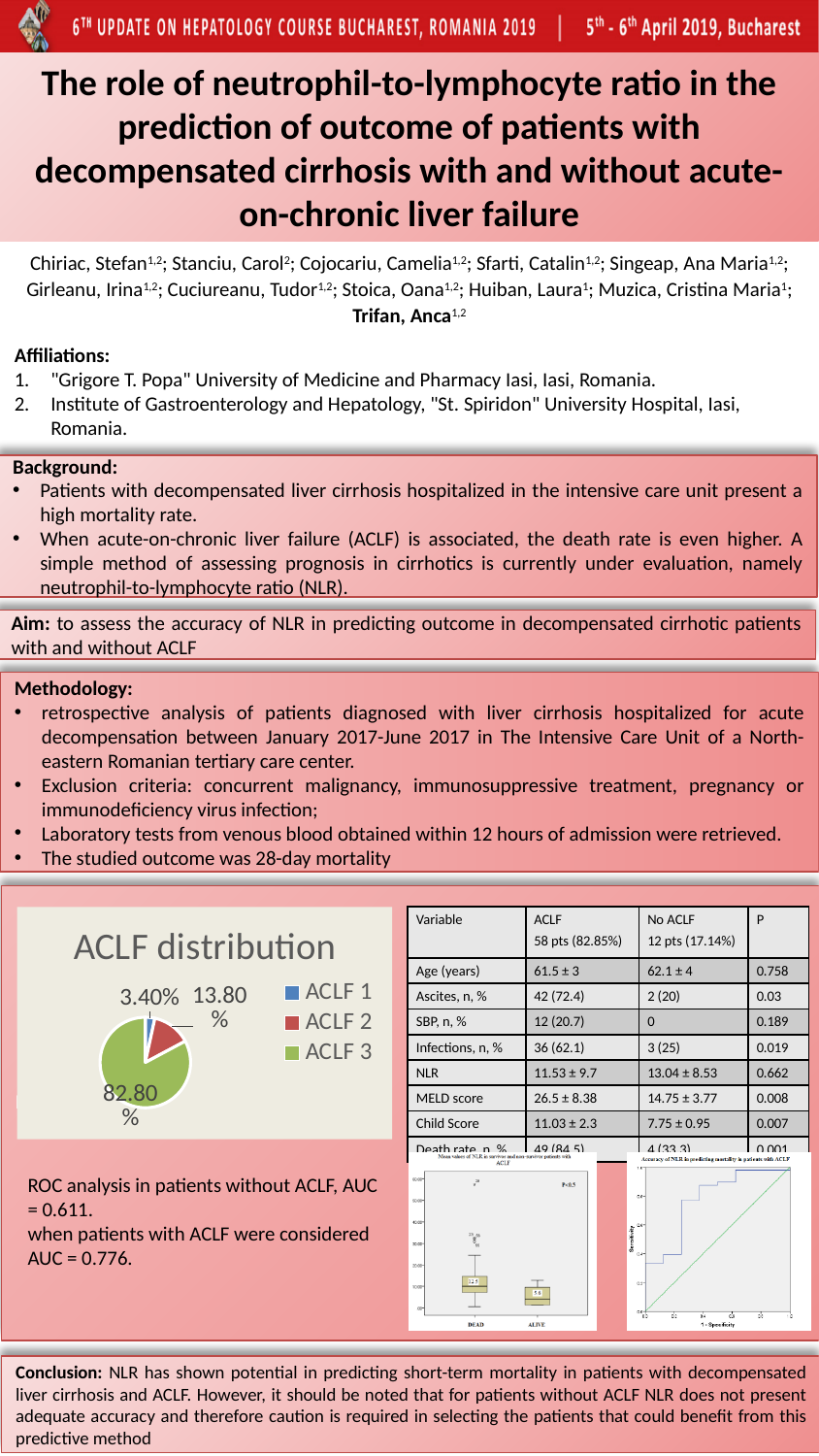
What kind of chart is the "ACLF distribution" chart? pie chart In the "ACLF distribution" pie chart, which is larger, the share for ACLF 2 or the share for ACLF 1? ACLF 2 In the "ACLF distribution" pie chart, what is the combined share of ACLF 1 and ACLF 2? 17.20% In the "ACLF distribution" pie chart, what share is shown for ACLF 1? 3.40% Which category has the smallest slice in the "ACLF distribution" pie chart? ACLF 1 What is the title of the pie chart on the slide? ACLF distribution In the "ACLF distribution" pie chart, what share is shown for ACLF 3? 82.80% Which category has the largest slice in the "ACLF distribution" pie chart? ACLF 3 How many categories does the legend of the "ACLF distribution" pie chart list? 3 In the "ACLF distribution" pie chart, what is the difference between the shares for ACLF 3 and ACLF 2? 69.00% In the "ACLF distribution" pie chart, what share is shown for ACLF 2? 13.80% In the "ACLF distribution" pie chart, what colour is the ACLF 3 slice? green